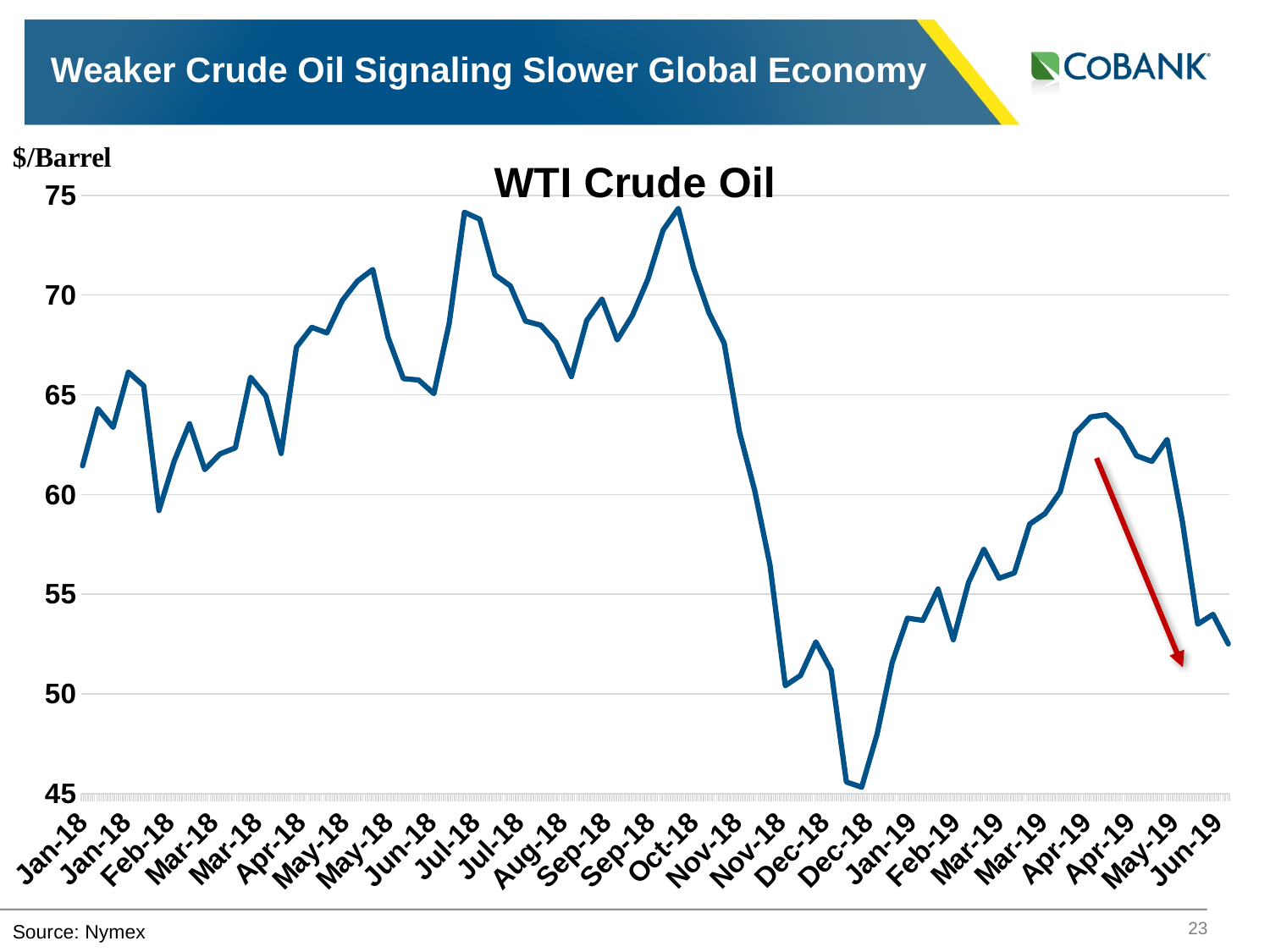
Is the value at the start of the line, at Jan-18, greater or less than 60? greater What unit is shown on the y axis of the chart? $/Barrel Does the line rise or fall between Oct-18 and Dec-18? fall Is the peak value around Oct-18 greater or less than 70? greater Is the value at the end of the line, at Jun-19, greater or less than 55? less How many data series are plotted on the chart? 1 Does the line rise or fall between Dec-18 and Apr-19? rise What is the title of the chart? WTI Crude Oil Around which month does the line reach its lowest point? Dec-18 What kind of chart is shown on the slide? line chart Does the line rise or fall between Apr-19 and Jun-19? fall